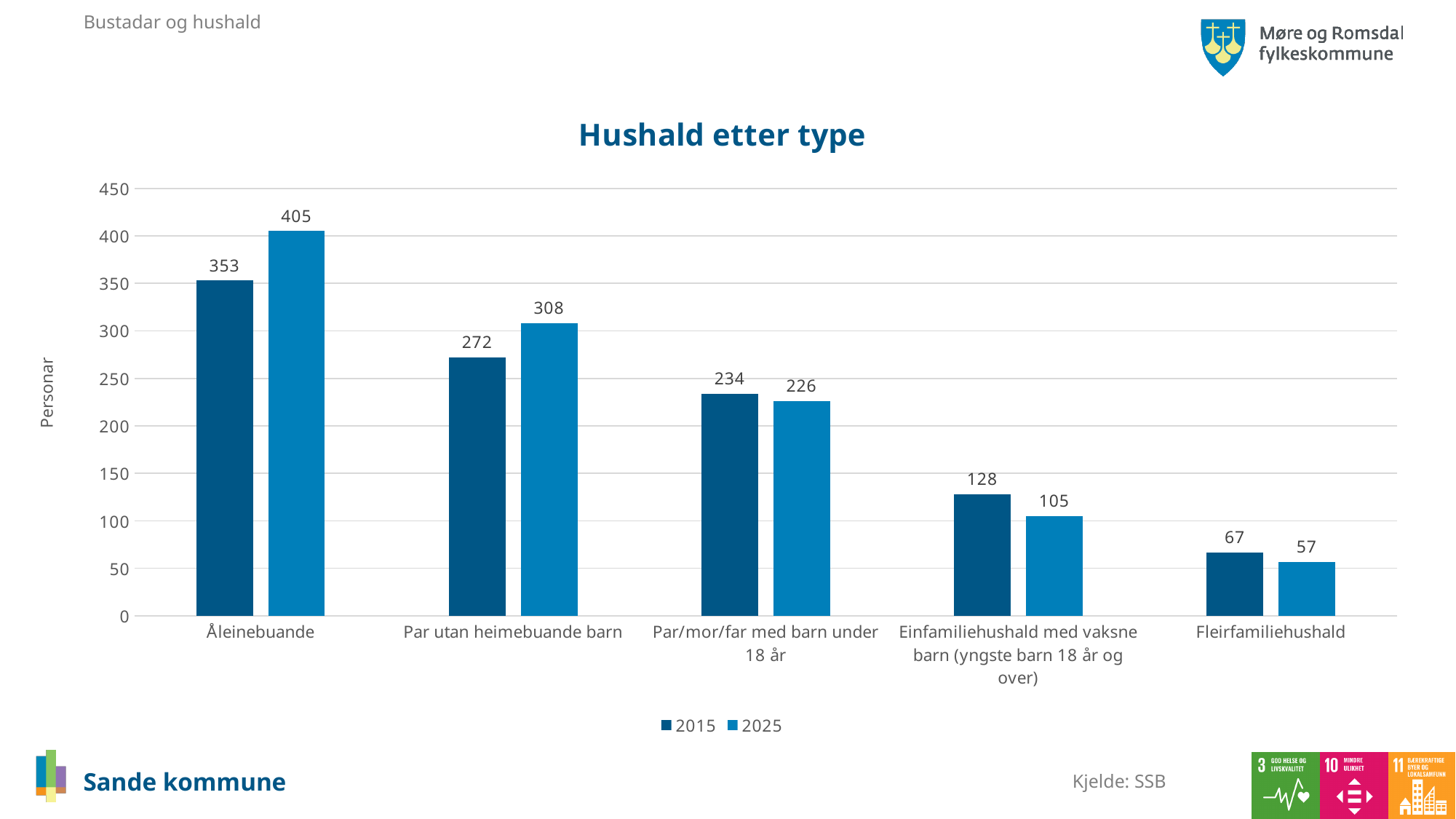
What is the value for Par utan heimebuande barn in 2015? 272 How many categories are shown on the x axis? 5 Is the 2025 value for Par utan heimebuande barn greater or less than 300? greater What is the difference between the 2025 and 2015 values for Åleinebuande? 52 What kind of chart is shown on the slide? Bar chart Which category has the lowest value in 2025? Fleirfamiliehushald What is the difference between the 2015 and 2025 values for Einfamiliehushald med vaksne barn (yngste barn 18 år og over)? 23 How many series does the legend list? 2 What is the value for Fleirfamiliehushald in 2025? 57 Which is larger for Par/mor/far med barn under 18 år: the 2015 value or the 2025 value? 2015 Which category has the highest value in 2015? Åleinebuande What is the value for Åleinebuande in 2025? 405